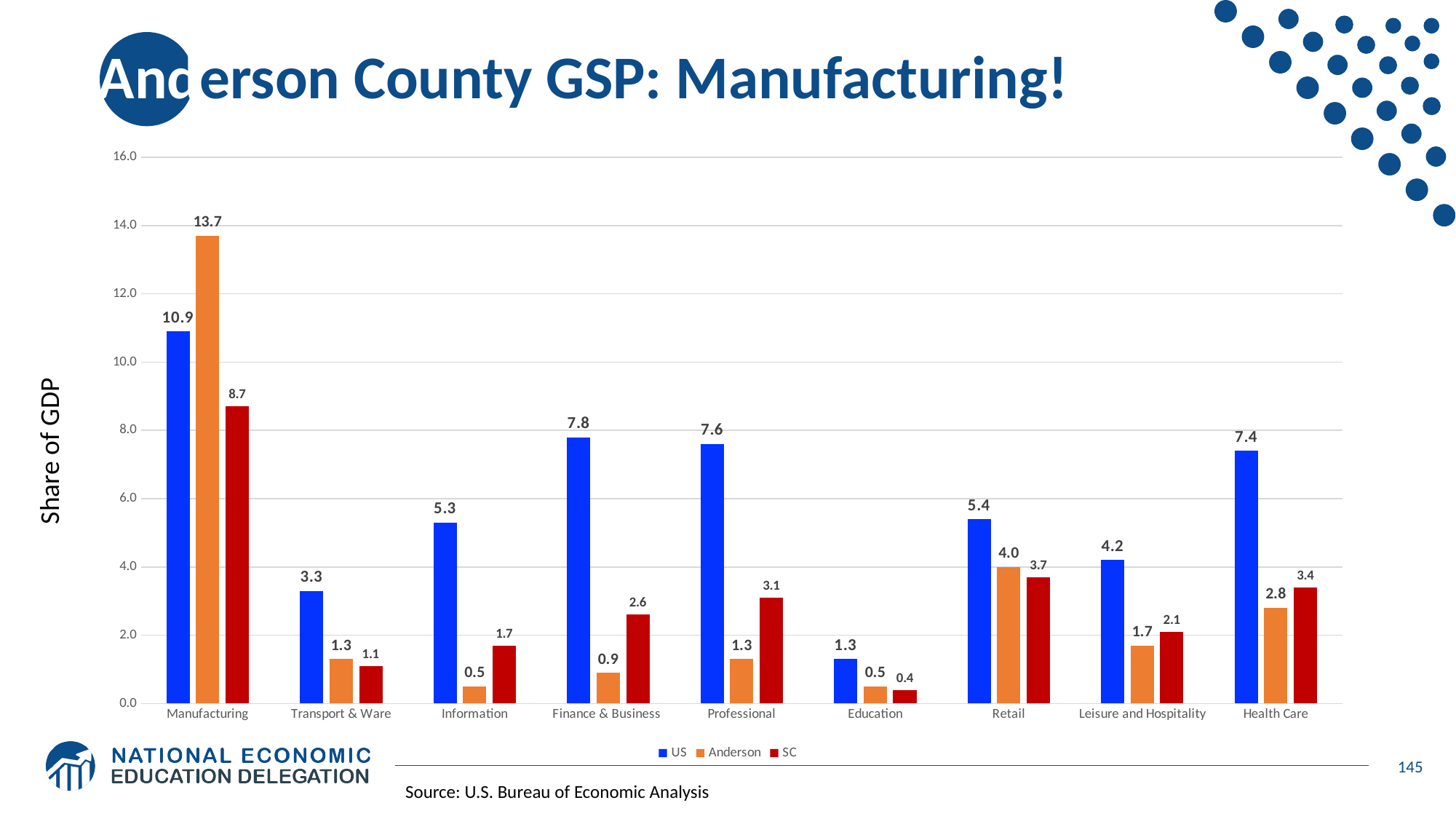
What is the Anderson value for Manufacturing? 13.7 What is the SC value for Finance & Business? 2.6 What is the difference between the Anderson and US values for Manufacturing? 2.8 How many series does the legend list? 3 What is the difference between the US and SC values for Professional? 4.5 What is the US value for Health Care? 7.4 Which is larger for Retail: the US value or the Anderson value? US What is the label on the vertical axis? Share of GDP What kind of chart is shown on the slide? Bar chart Which category has the lowest SC value? Education How many categories are shown on the x axis? 9 Which category has the highest Anderson value? Manufacturing